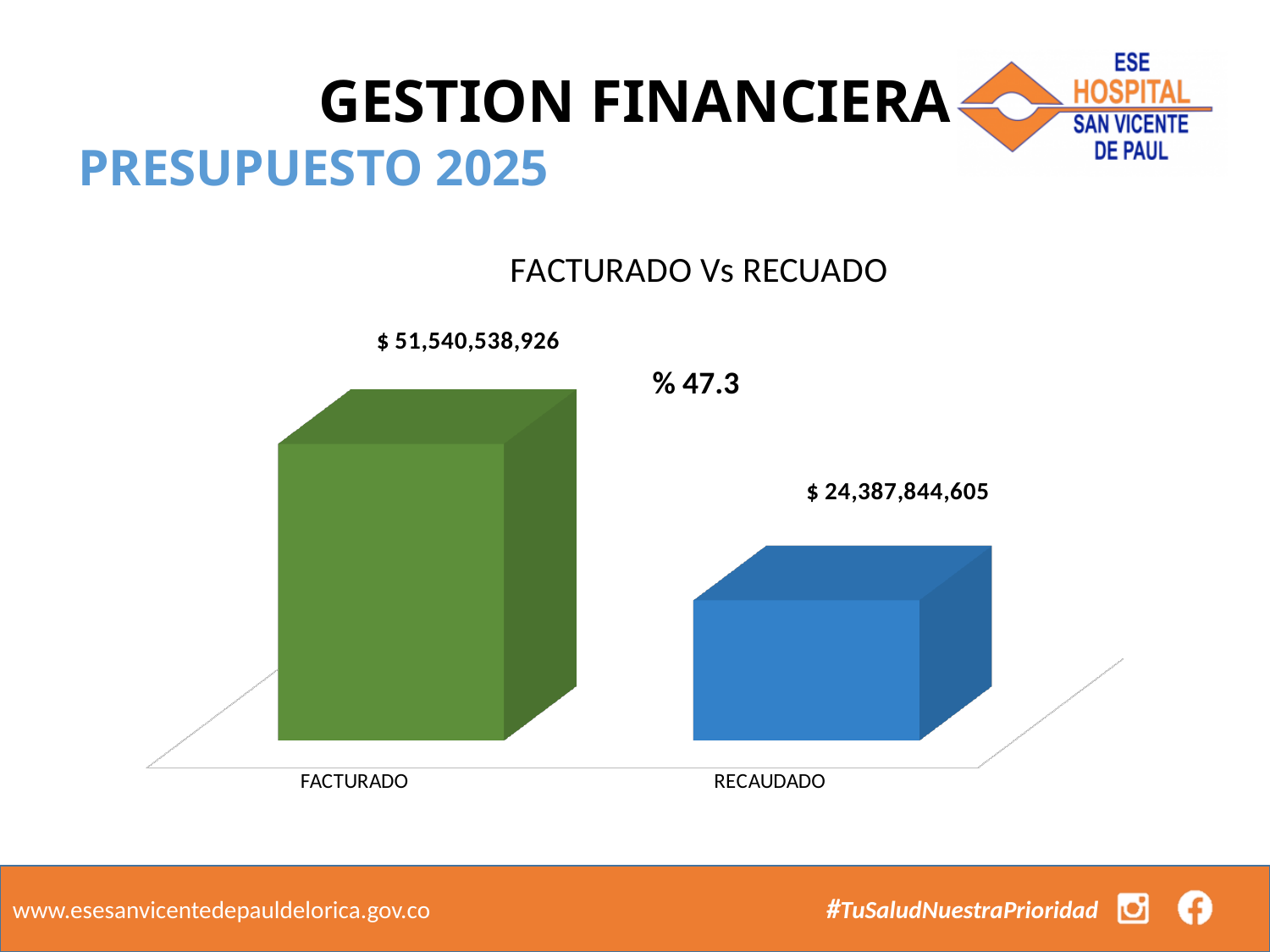
What is the difference between the FACTURADO and RECAUDADO values? $ 27,152,694,321 How many categories are shown in the chart? 2 What type of chart is shown on the slide? bar chart Do the values rise or fall from FACTURADO to RECAUDADO? fall Which category has the lowest value? RECAUDADO Which category has the highest value? FACTURADO What is the value for FACTURADO? $ 51,540,538,926 What percentage is annotated on the chart between the two bars? % 47.3 What is the title of the chart? FACTURADO Vs RECUADO Which is larger, FACTURADO or RECAUDADO? FACTURADO What is the value for RECAUDADO? $ 24,387,844,605